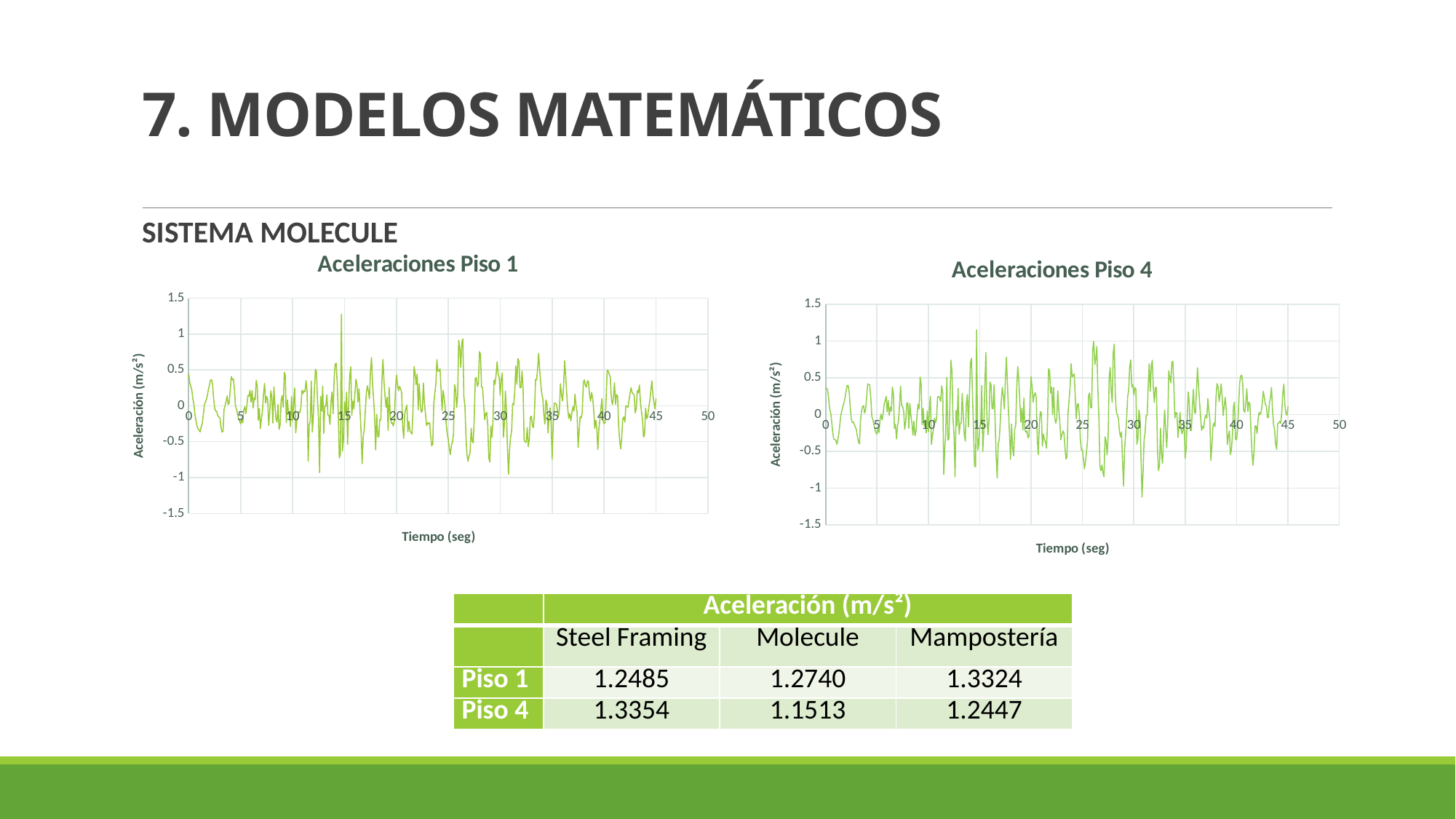
In the "Aceleraciones Piso 4" chart, is the lowest trough of the line greater or less than -1.5? greater What is the y-axis title of the "Aceleraciones Piso 4" chart? Aceleración (m/s²) What is the highest tick value shown on the x axis of the "Aceleraciones Piso 1" chart? 50 In the "Aceleraciones Piso 1" chart, is the highest peak of the line greater or less than 1.5? less How many line charts are shown on the slide? 2 What kind of chart is "Aceleraciones Piso 1"? Line chart In the "Aceleraciones Piso 4" chart, is the highest peak of the line greater or less than 1? greater What kind of chart is "Aceleraciones Piso 4"? Line chart What is the x-axis title of the "Aceleraciones Piso 1" chart? Tiempo (seg) What is the lowest tick value shown on the y axis of the "Aceleraciones Piso 4" chart? -1.5